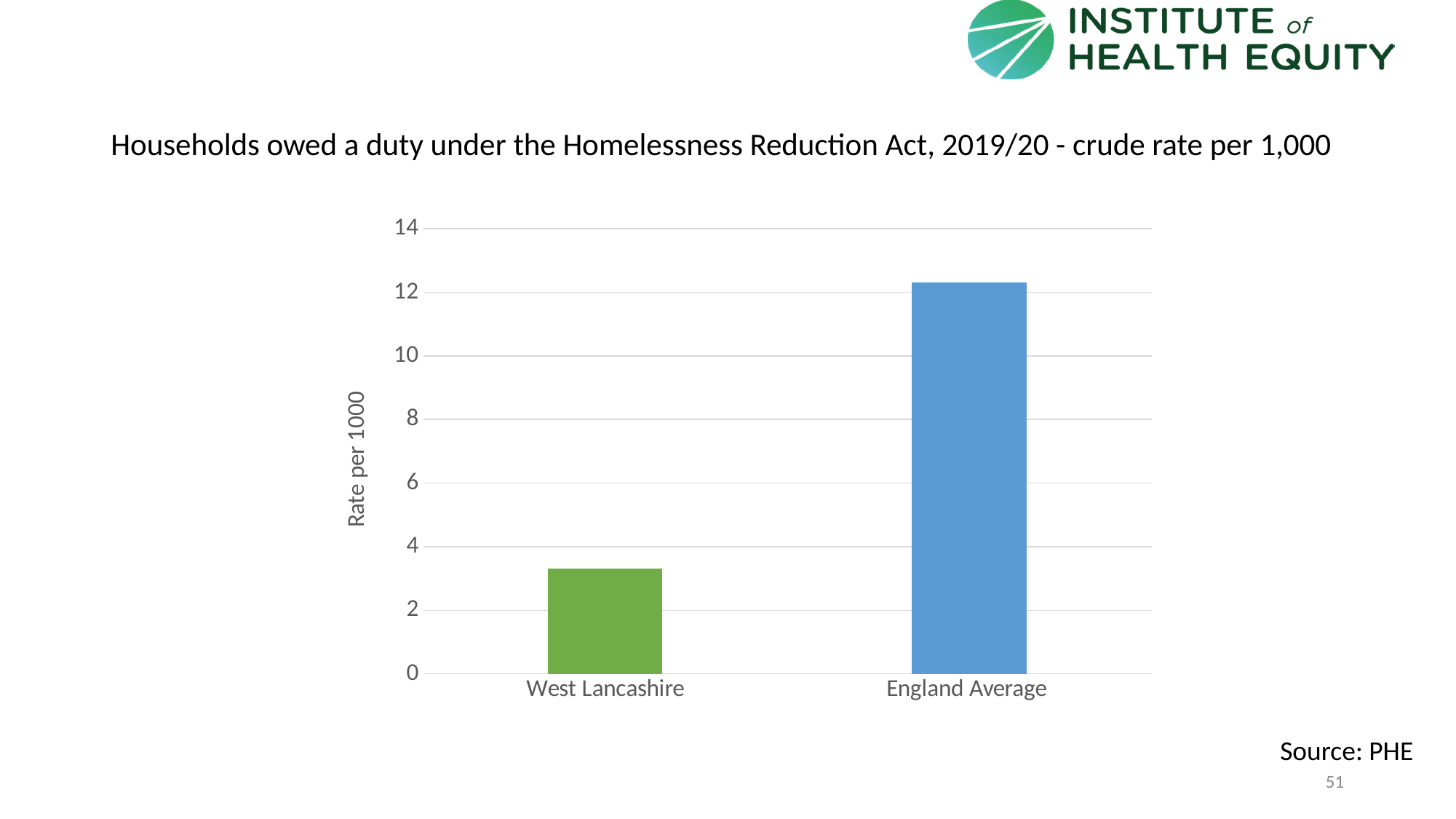
What is the title of the chart? Households owed a duty under the Homelessness Reduction Act, 2019/20 - crude rate per 1,000 How many categories are plotted on the chart? 2 Is the value for West Lancashire greater or less than 2? greater Which category has the lowest rate per 1,000? West Lancashire Is the value for West Lancashire greater or less than 4? less Is the value for England Average greater or less than 10? greater Which category has the highest rate per 1,000? England Average What is the label on the vertical axis of the chart? Rate per 1000 Which is larger, the value for West Lancashire or the value for England Average? England Average What kind of chart is shown on the slide? bar chart